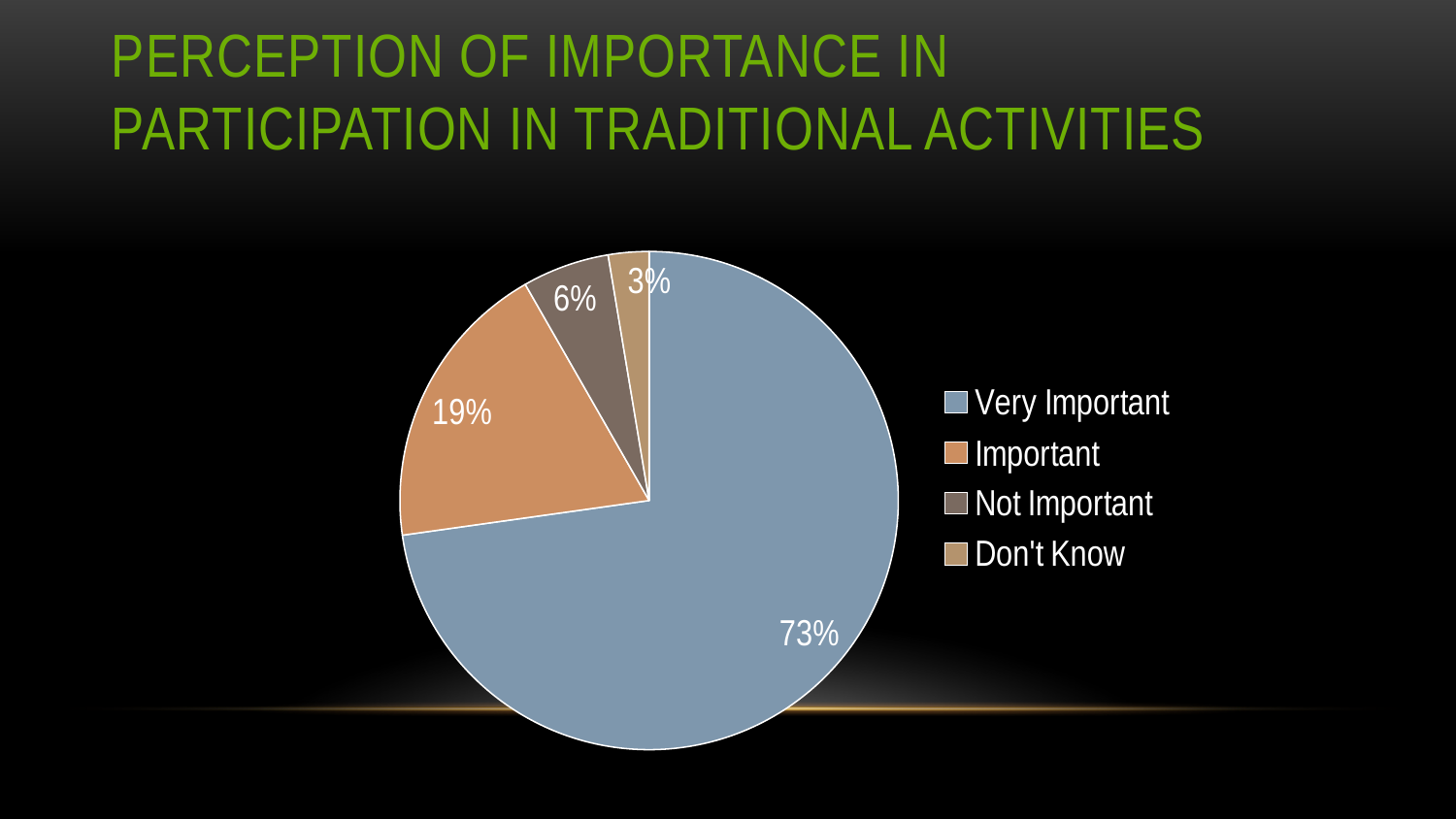
How many categories does the legend list? 4 What percentage of the pie is labelled Not Important? 6% What percentage of the pie is labelled Important? 19% Which slice is larger, Not Important or Don't Know? Not Important What percentage of the pie is labelled Very Important? 73% Which category has the largest slice of the pie? Very Important What kind of chart is shown on the slide? pie chart Which category has the smallest slice of the pie? Don't Know What is the title of the chart slide? Perception of Importance in Participation in Traditional Activities What colour is the Important slice in the pie chart? orange What percentage of the pie is labelled Don't Know? 3% What is the difference in percentage points between the Very Important and Important slices? 54